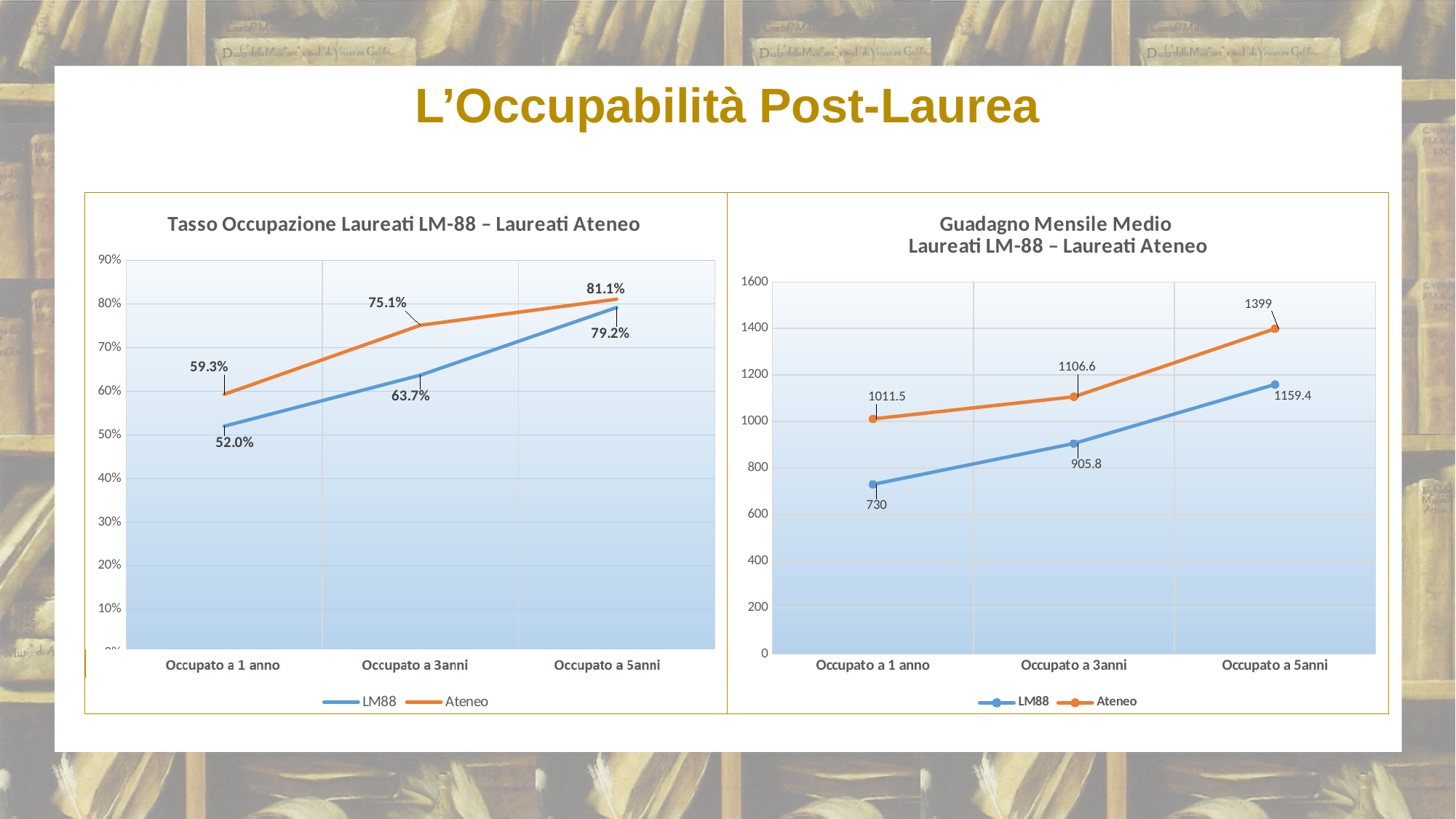
In the 'Guadagno Mensile Medio Laureati LM-88 – Laureati Ateneo' chart, what is the Ateneo value for 'Occupato a 5anni'? 1399 In the 'Guadagno Mensile Medio Laureati LM-88 – Laureati Ateneo' chart, what is the difference between the Ateneo and LM88 values at 'Occupato a 1 anno'? 281.5 In the 'Tasso Occupazione Laureati LM-88 – Laureati Ateneo' chart, which series has the higher value at 'Occupato a 1 anno', LM88 or Ateneo? Ateneo In the 'Tasso Occupazione Laureati LM-88 – Laureati Ateneo' chart, do the LM88 values rise or fall from 'Occupato a 1 anno' to 'Occupato a 5anni'? rise In the 'Guadagno Mensile Medio Laureati LM-88 – Laureati Ateneo' chart, at which category is the LM88 value lowest? Occupato a 1 anno In the 'Tasso Occupazione Laureati LM-88 – Laureati Ateneo' chart, what is the Ateneo value for 'Occupato a 3anni'? 75.1% In the 'Tasso Occupazione Laureati LM-88 – Laureati Ateneo' chart, what is the LM88 value for 'Occupato a 1 anno'? 52.0% In the 'Guadagno Mensile Medio Laureati LM-88 – Laureati Ateneo' chart, how many categories are shown on the x axis? 3 What kind of chart is the 'Guadagno Mensile Medio Laureati LM-88 – Laureati Ateneo' chart? line chart In the 'Tasso Occupazione Laureati LM-88 – Laureati Ateneo' chart, what is the difference between the Ateneo and LM88 values at 'Occupato a 5anni'? 1.9% In the 'Tasso Occupazione Laureati LM-88 – Laureati Ateneo' chart, how many series does the legend list? 2 In the 'Guadagno Mensile Medio Laureati LM-88 – Laureati Ateneo' chart, what is the LM88 value for 'Occupato a 3anni'? 905.8